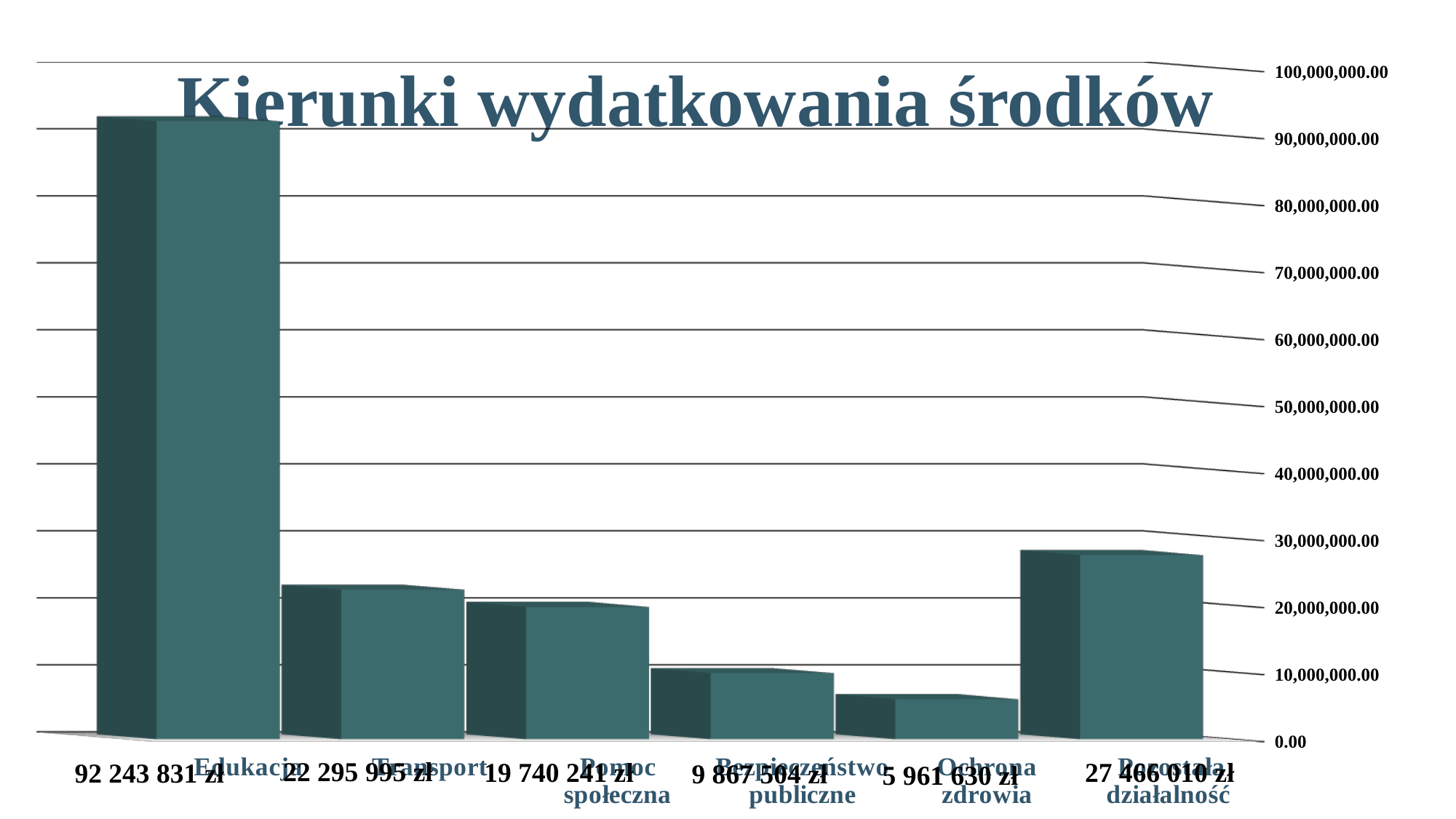
What is the value for Edukacja? 92 243 831 zł How many categories are shown in the chart? 6 What type of chart is shown on the slide? bar chart Is the value for Bezpieczeństwo publiczne greater or less than 10,000,000.00? less What is the value for Pozostała działalność? 27 466 010 zł What is the title of the chart? Kierunki wydatkowania środków What is the value for Transport? 22 295 995 zł What is the value for Ochrona zdrowia? 5 961 630 zł Which category has the lowest value? Ochrona zdrowia Which is larger, the value for Pozostała działalność or the value for Transport? Pozostała działalność What is the difference between the values for Edukacja and Transport? 69 947 836 zł Which category has the highest value? Edukacja